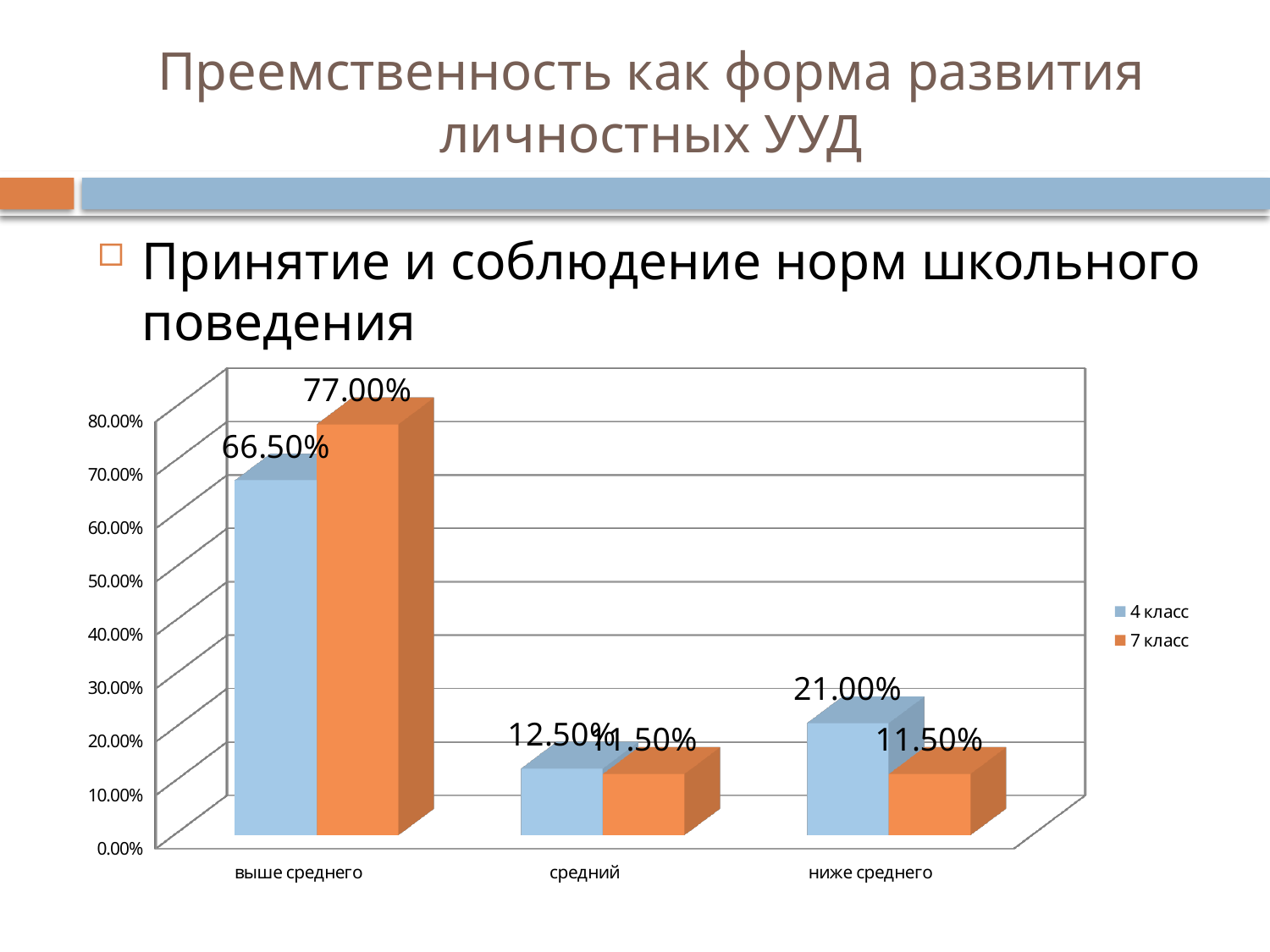
What kind of chart is shown on the slide? bar chart How many series does the legend list? 2 Which category has the lowest value for 4 класс? средний What is the value for 7 класс in the category выше среднего? 77.00% How many categories are shown on the x axis? 3 Which category has the highest value for 7 класс? выше среднего In the category ниже среднего, which series has the larger value, 4 класс or 7 класс? 4 класс What is the value for 7 класс in the category средний? 11.50% What colour are the bars for 7 класс? orange What is the value for 4 класс in the category выше среднего? 66.50% What is the difference between the 7 класс and 4 класс values in the category выше среднего? 10.50% What is the value for 4 класс in the category ниже среднего? 21.00%